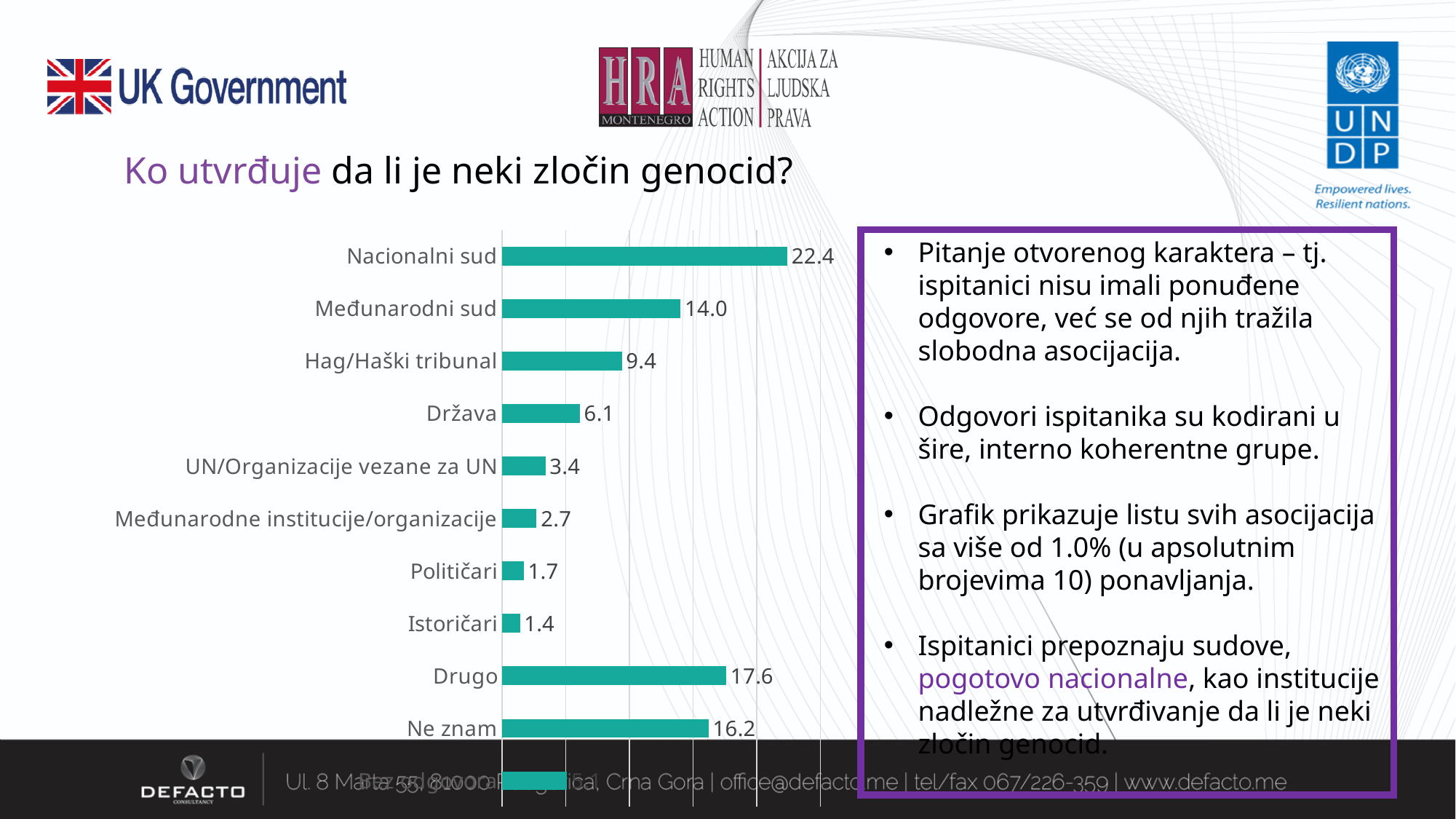
What is the difference between the values for Nacionalni sud and Međunarodni sud? 8.4 Which category has the lowest value? Istoričari What colour are the bars in the chart? teal What is the value for Nacionalni sud? 22.4 What is the value for Hag/Haški tribunal? 9.4 What is the value for Međunarodni sud? 14.0 Which is larger, the value for Drugo or the value for Ne znam? Drugo Which category has the highest value? Nacionalni sud What is the difference between the values for Država and UN/Organizacije vezane za UN? 2.7 What is the value for Ne znam? 16.2 What type of chart is shown on the slide? bar chart What is the value for Političari? 1.7